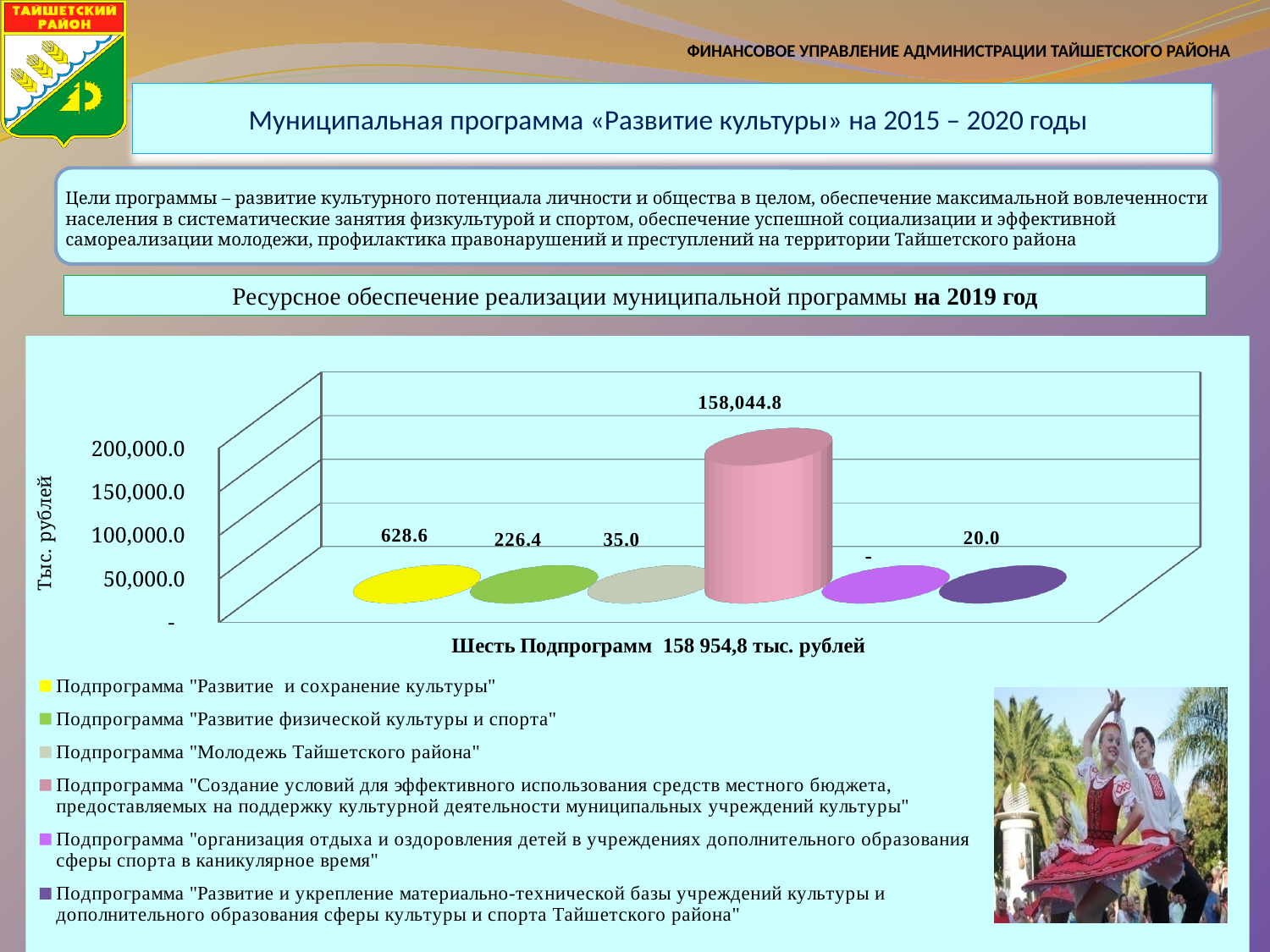
What is the value for the subprogram "Развитие и сохранение культуры"? 628.6 Which subprogram has the highest value? Подпрограмма "Создание условий для эффективного использования средств местного бюджета, предоставляемых на поддержку культурной деятельности муниципальных учреждений культуры" How many series does the legend list? 6 What is the value for the subprogram "Создание условий для эффективного использования средств местного бюджета..."? 158,044.8 Which is larger: the value for "Молодежь Тайшетского района" or the value for "Развитие и укрепление материально-технической базы..."? Молодежь Тайшетского района What is the value for the subprogram "Молодежь Тайшетского района"? 35.0 Is the value for "Создание условий для эффективного использования средств местного бюджета..." greater or less than 150,000.0? greater What is the value for the subprogram "Развитие и укрепление материально-технической базы учреждений культуры..."? 20.0 What is the value for the subprogram "Развитие физической культуры и спорта"? 226.4 What unit is shown on the vertical axis of the chart? Тыс. рублей What kind of chart is shown on the slide? bar chart What is the difference between the values for "Развитие и сохранение культуры" and "Развитие физической культуры и спорта"? 402.2